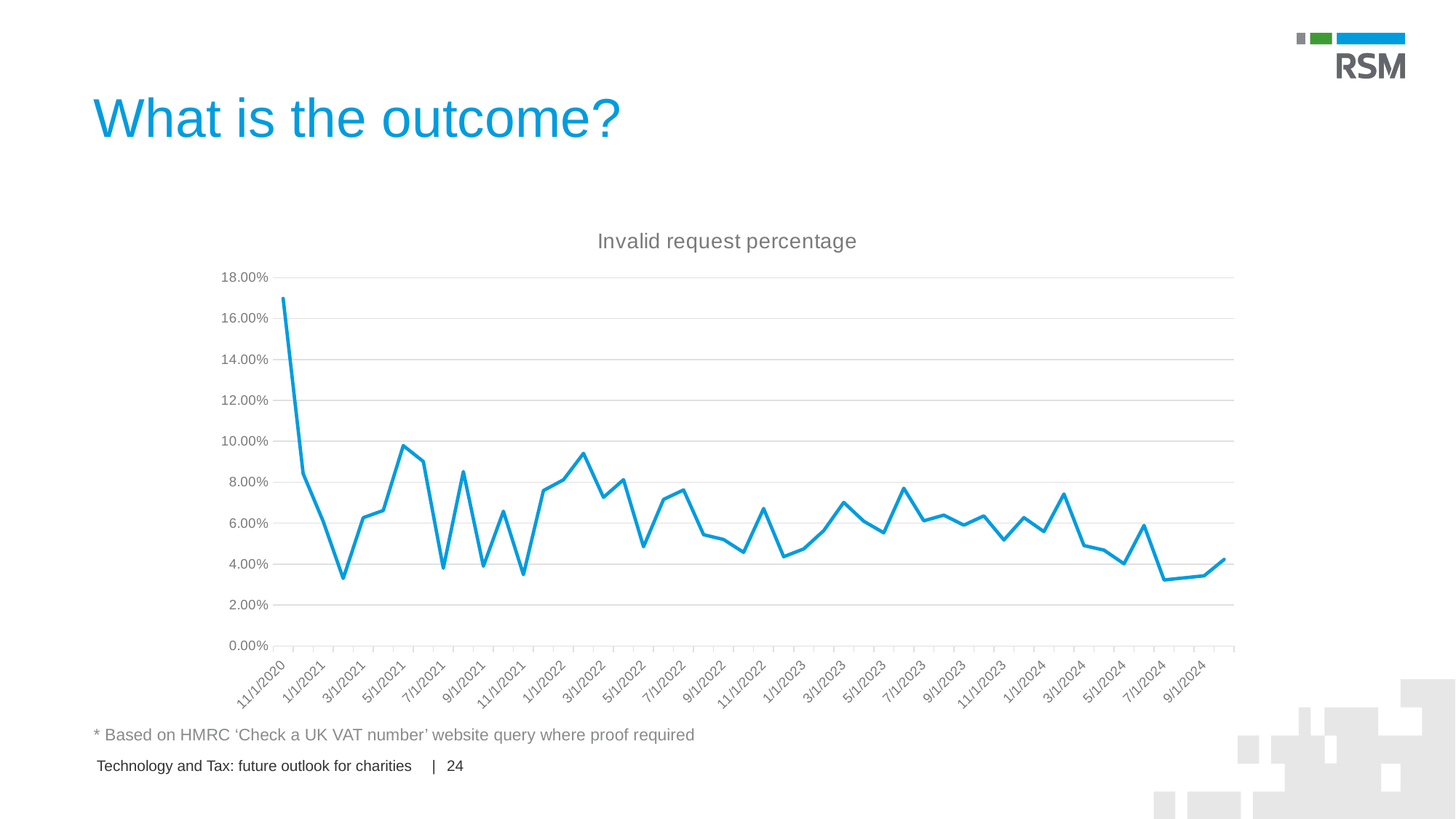
Is the value for 7/1/2024 greater or less than 4.00%? less Is the value for 3/1/2021 greater or less than 4.00%? greater Is the value for 11/1/2020 greater or less than 16.00%? greater Which date has the highest invalid request percentage? 11/1/2020 What is the title of the chart? Invalid request percentage What kind of chart is shown on the slide? line chart Overall, does the invalid request percentage rise or fall from 11/1/2020 to the end of the series? fall Which is larger, the value for 11/1/2020 or the value for 1/1/2021? 11/1/2020 Which is larger, the value for 3/1/2022 or the value for 1/1/2023? 3/1/2022